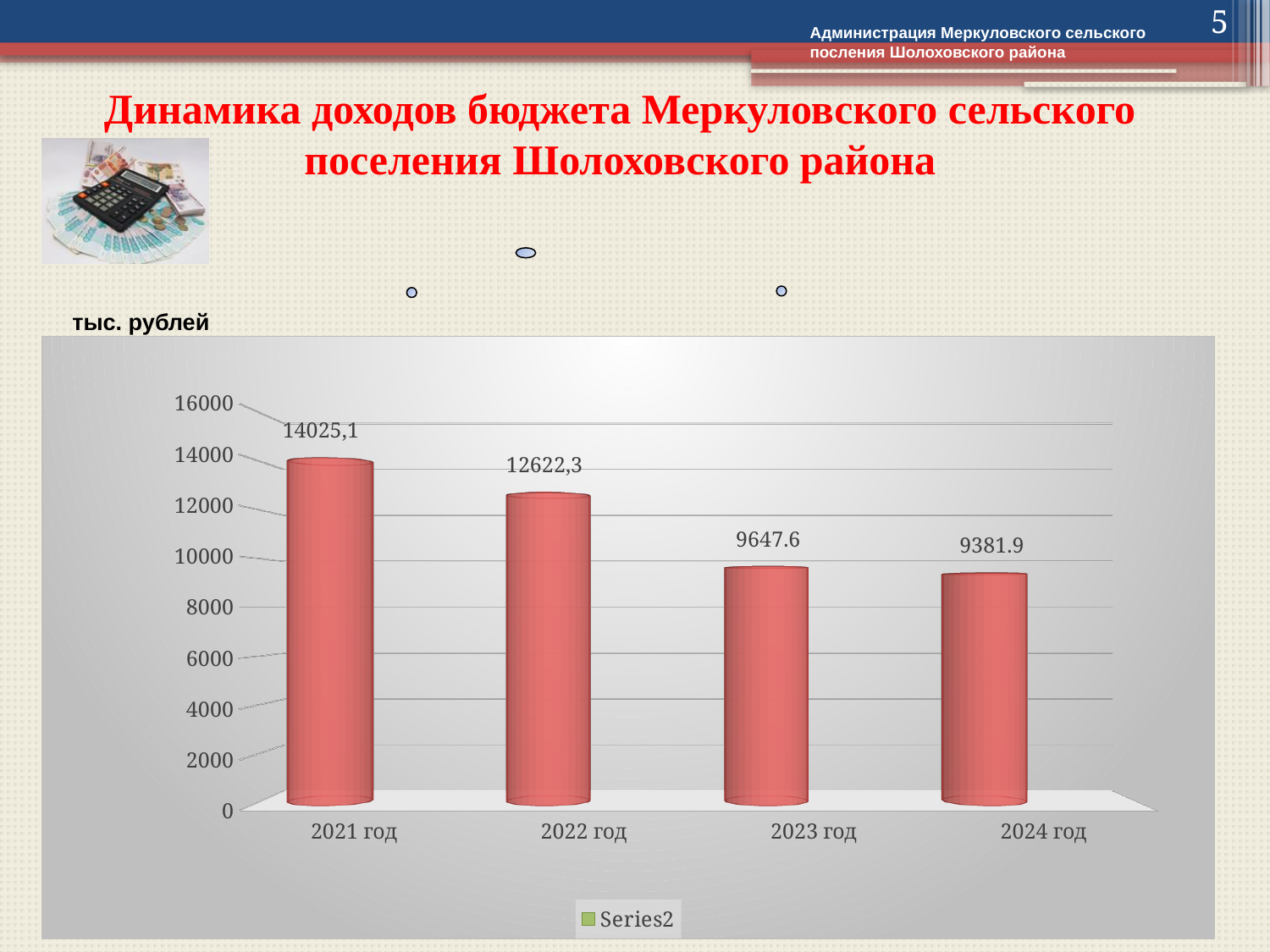
Which year has the lowest value? 2024 год What is the difference between the values for 2023 год and 2024 год? 265.7 Which is larger, the value for 2023 год or the value for 2024 год? 2023 год Which year has the highest value? 2021 год What is the value for 2021 год? 14025,1 What is the value for 2024 год? 9381.9 Do the values rise or fall from 2021 год to 2024 год? Fall What kind of chart is shown on the slide? Bar chart How many years are shown on the x axis? 4 What is the value for 2022 год? 12622,3 What is the difference between the values for 2021 год and 2022 год? 1402,8 What is the value for 2023 год? 9647.6